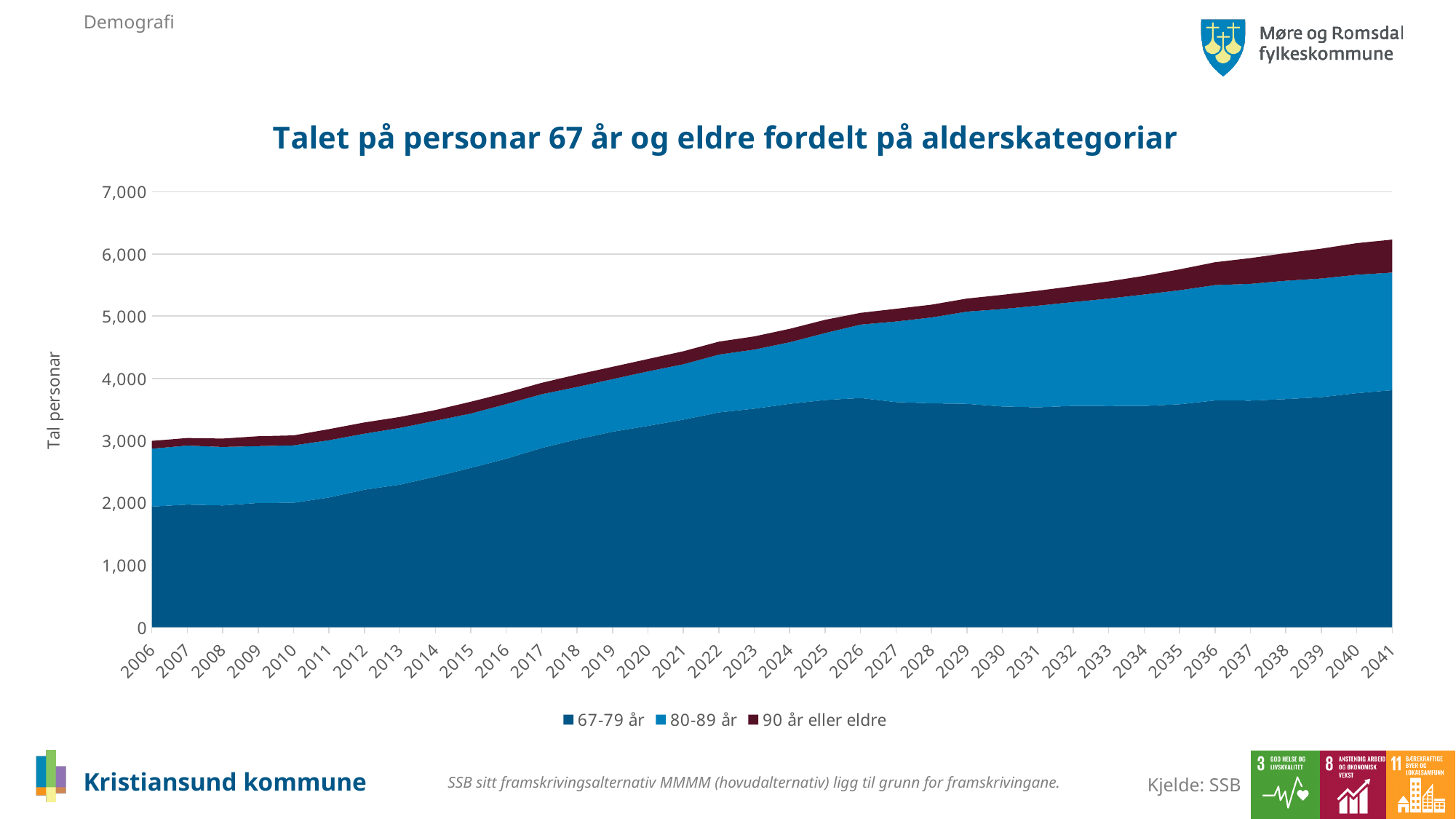
Which is larger, the value for 67-79 år in 2026 or in 2006? 2026 Is the total for all age categories in 2006 greater or less than 4,000? less Which year has the highest total number of persons 67 år og eldre? 2041 Does the total number of persons 67 år og eldre rise or fall from 2006 to 2041? rise What is the title of the chart? Talet på personar 67 år og eldre fordelt på alderskategoriar Is the total for all age categories in 2041 greater or less than 6,000? greater How many years are shown along the x axis? 36 Is the total for all age categories in 2030 greater or less than 5,000? greater What is the label on the y axis? Tal personar How many series does the legend list? 3 What kind of chart is shown on the slide? stacked area chart